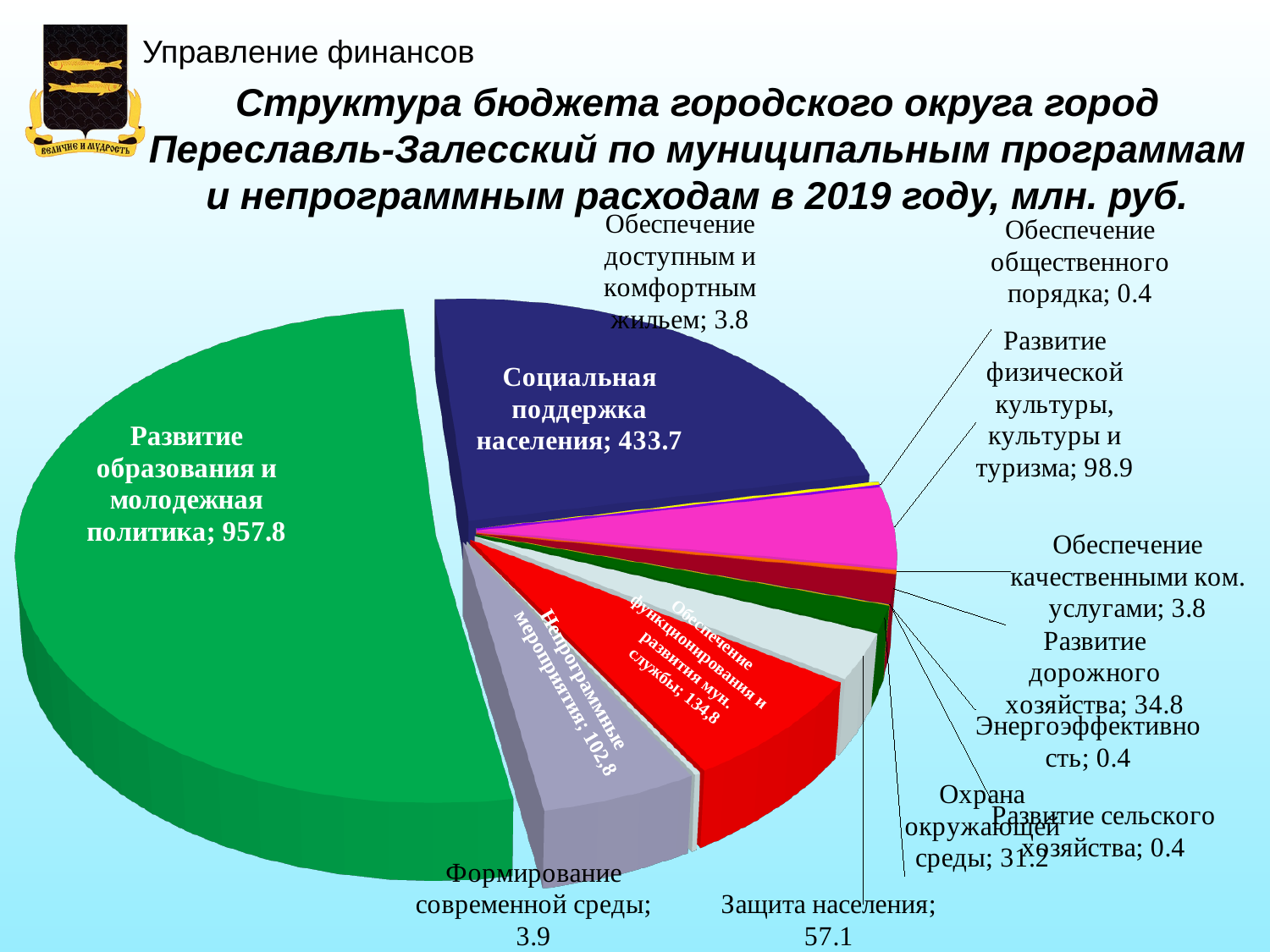
Which is larger: Обеспечение функционирования и развития мун. службы or Непрограммные мероприятия? Обеспечение функционирования и развития мун. службы What is the difference between Защита населения and Охрана окружающей среды? 25.9 Which category has the largest slice of the pie? Развитие образования и молодежная политика In what units are the values in the chart expressed, according to the title? млн. руб. What is the value for Непрограммные мероприятия? 102.8 What is the value for Развитие дорожного хозяйства? 34.8 What is the value for Социальная поддержка населения? 433.7 What is the difference between Развитие образования и молодежная политика and Социальная поддержка населения? 524.1 What is the value for Развитие образования и молодежная политика? 957.8 What kind of chart is shown on the slide? Pie chart What is the value for Развитие физической культуры, культуры и туризма? 98.9 What is the value for Защита населения? 57.1